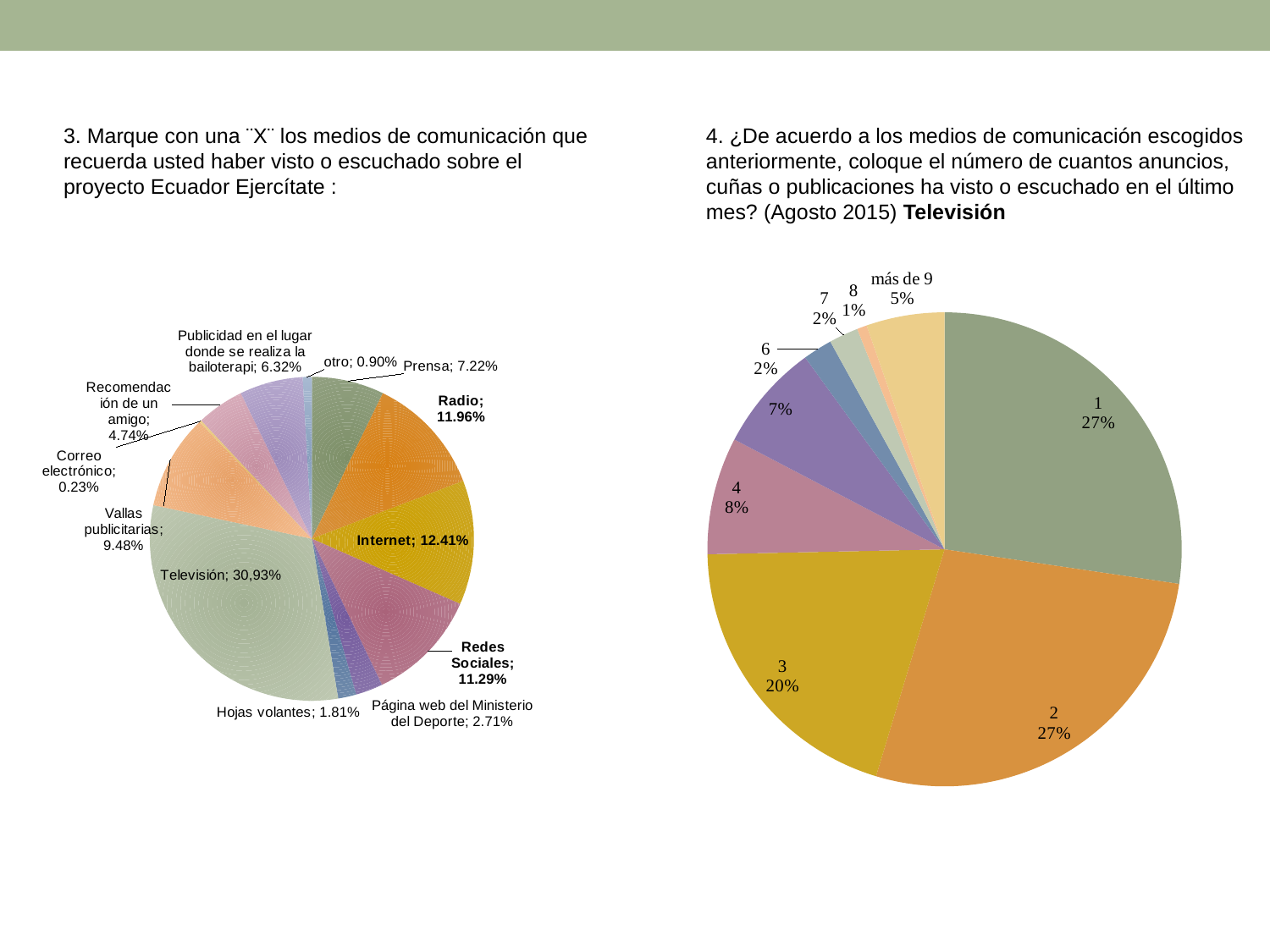
How many categories are shown in the left pie chart (question 3)? 12 In the left pie chart (question 3), what percentage is shown for Televisión? 30,93% In the Televisión pie chart (question 4), which is larger, the slice for 4 or the slice for 6? 4 What type of chart is used for the Televisión data (question 4)? Pie chart In the left pie chart (question 3), what percentage is shown for Internet? 12.41% In the left pie chart (question 3), what percentage is shown for Vallas publicitarias? 9.48% In the Televisión pie chart (question 4), what share is shown for 'más de 9'? 5% In the left pie chart (question 3), which category has the smallest share? Correo electrónico In the Televisión pie chart (question 4), what share is shown for 3 anuncios? 20% In the left pie chart (question 3), which category has the largest share? Televisión In the left pie chart (question 3), what is the difference between the Internet share and the Prensa share? 5.19% In the left pie chart (question 3), which is larger, Radio or Redes Sociales? Radio